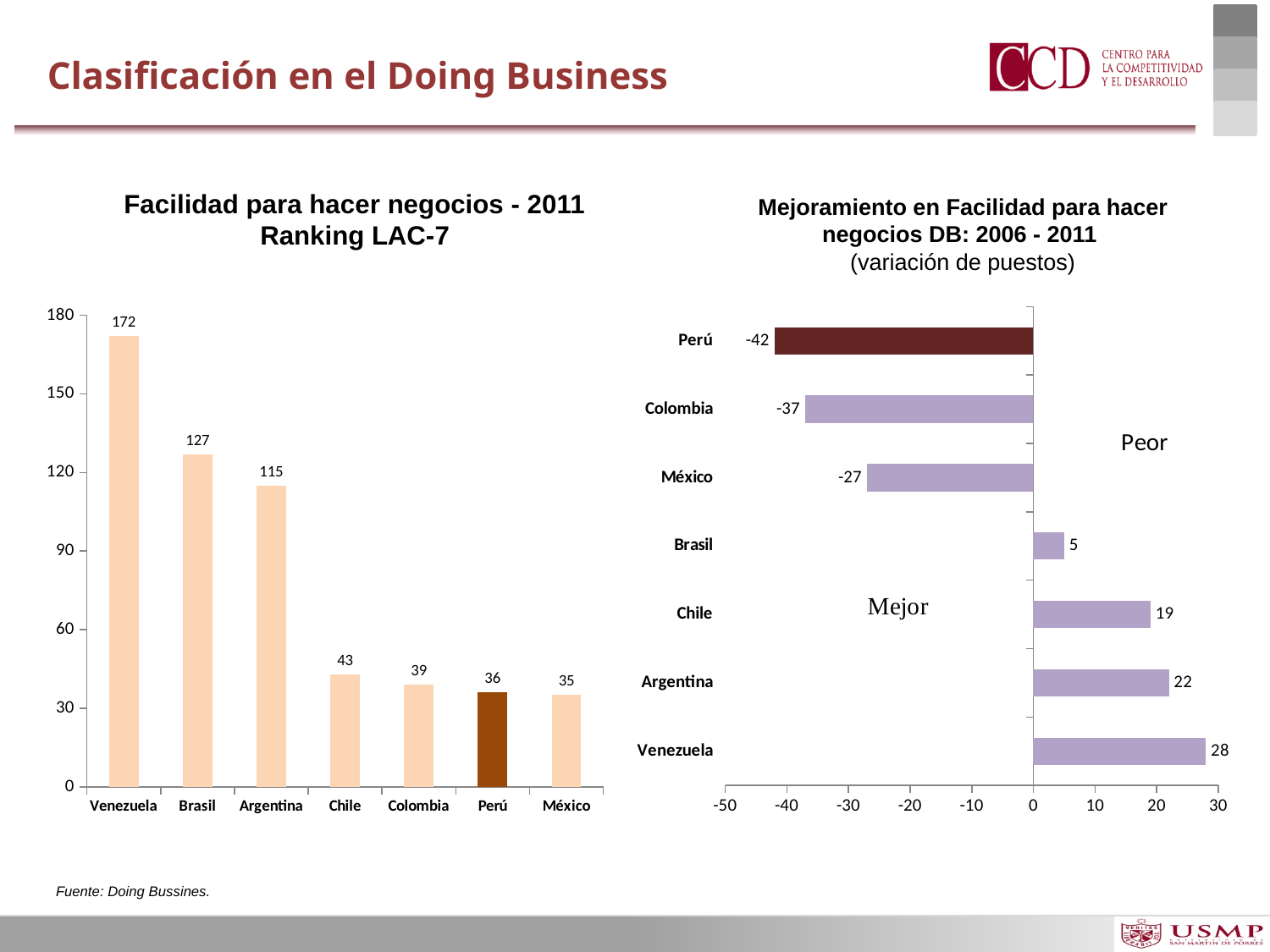
What kind of chart is the right chart (Mejoramiento en Facilidad para hacer negocios DB: 2006 - 2011)? bar chart In the left chart (Facilidad para hacer negocios - 2011 Ranking LAC-7), what is the value for Venezuela? 172 In the left chart (Facilidad para hacer negocios - 2011 Ranking LAC-7), which country has the lowest value? México In the right chart (Mejoramiento en Facilidad para hacer negocios DB: 2006 - 2011), which country has the highest value? Venezuela In the right chart (Mejoramiento en Facilidad para hacer negocios DB: 2006 - 2011), what is the value for Perú? -42 In the left chart (Facilidad para hacer negocios - 2011 Ranking LAC-7), do the values rise or fall from left to right? fall In the left chart (Facilidad para hacer negocios - 2011 Ranking LAC-7), how many countries are shown? 7 In the right chart (Mejoramiento en Facilidad para hacer negocios DB: 2006 - 2011), which is larger, the value for Chile or the value for Argentina? Argentina In the left chart (Facilidad para hacer negocios - 2011 Ranking LAC-7), what is the difference between the values for Brasil and Argentina? 12 In the right chart (Mejoramiento en Facilidad para hacer negocios DB: 2006 - 2011), which country's bar is shown in a different (dark red) colour from the others? Perú In the left chart (Facilidad para hacer negocios - 2011 Ranking LAC-7), what is the value for Perú? 36 In the right chart (Mejoramiento en Facilidad para hacer negocios DB: 2006 - 2011), what is the value for Venezuela? 28